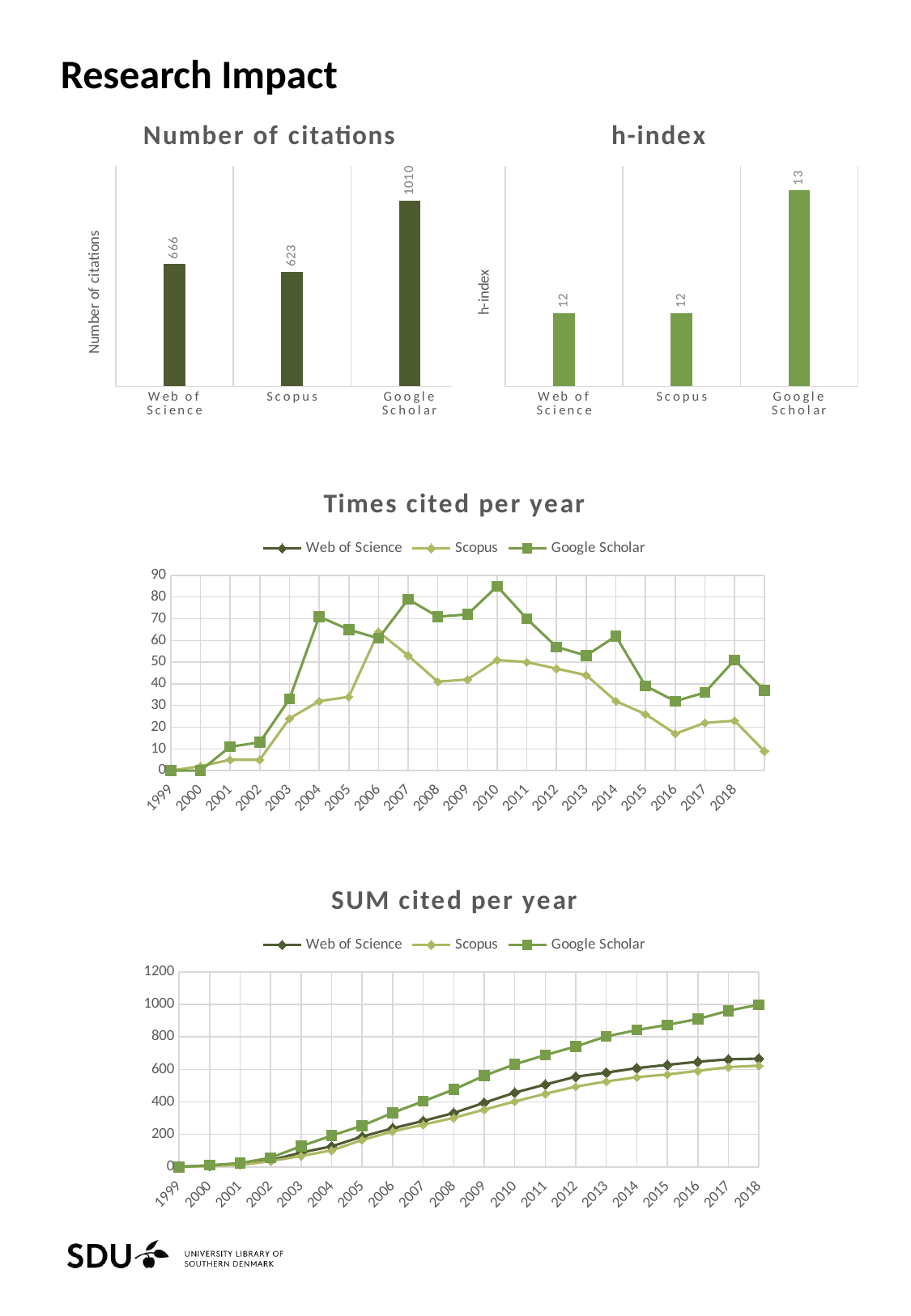
In the 'Times cited per year' chart, how many series does the legend list? 3 What kind of chart is 'SUM cited per year'? line chart In the 'h-index' chart, which source has the highest h-index? Google Scholar In the 'Number of citations' chart, what is the value for Google Scholar? 1010 In the 'h-index' chart, what is the h-index for Web of Science? 12 In the 'Times cited per year' chart, is the Google Scholar value for 2010 greater or less than 80? greater In the 'Times cited per year' chart, how many years are shown on the x axis? 20 In the 'Number of citations' chart, what is the value for Scopus? 623 In the 'SUM cited per year' chart, do the Google Scholar values rise or fall from 1999 to 2018? rise In the 'Number of citations' chart, which source has the lowest number of citations? Scopus In the 'h-index' chart, what is the difference between Google Scholar and Scopus? 1 In the 'Number of citations' chart, what is the difference between Google Scholar and Web of Science? 344